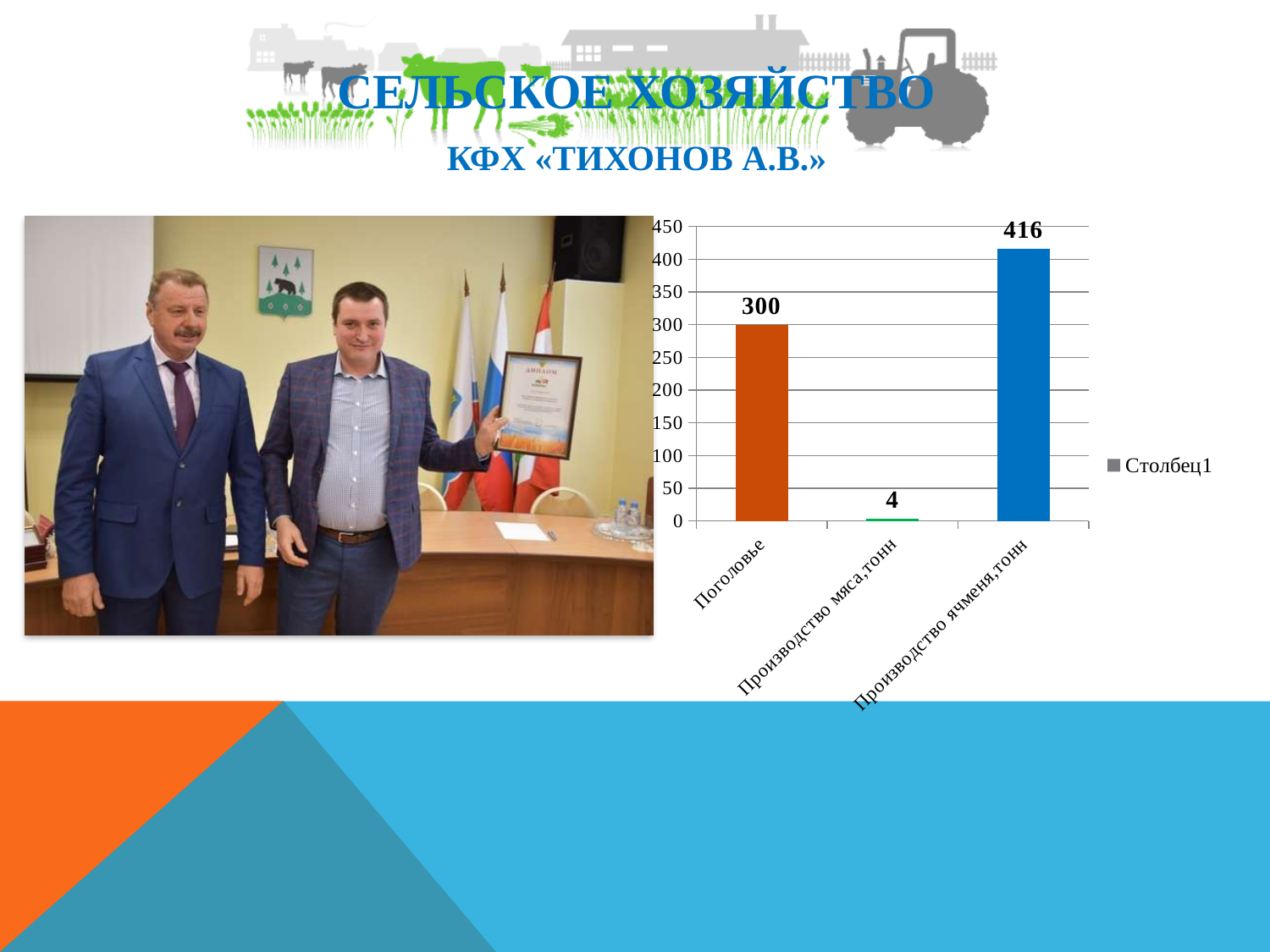
What is the value for Производство ячменя,тонн? 416 What is the value for Поголовье? 300 Which category has the lowest value? Производство мяса,тонн Which category has the highest value? Производство ячменя,тонн How many series does the legend list? 1 What is the legend entry shown on the chart? Столбец1 How many categories are shown on the chart? 3 What is the difference between the values for Производство ячменя,тонн and Поголовье? 116 What kind of chart is shown on the slide? bar chart Is the value for Производство ячменя,тонн greater or less than 400? greater What is the value for Производство мяса,тонн? 4 Which is larger, the value for Поголовье or the value for Производство мяса,тонн? Поголовье